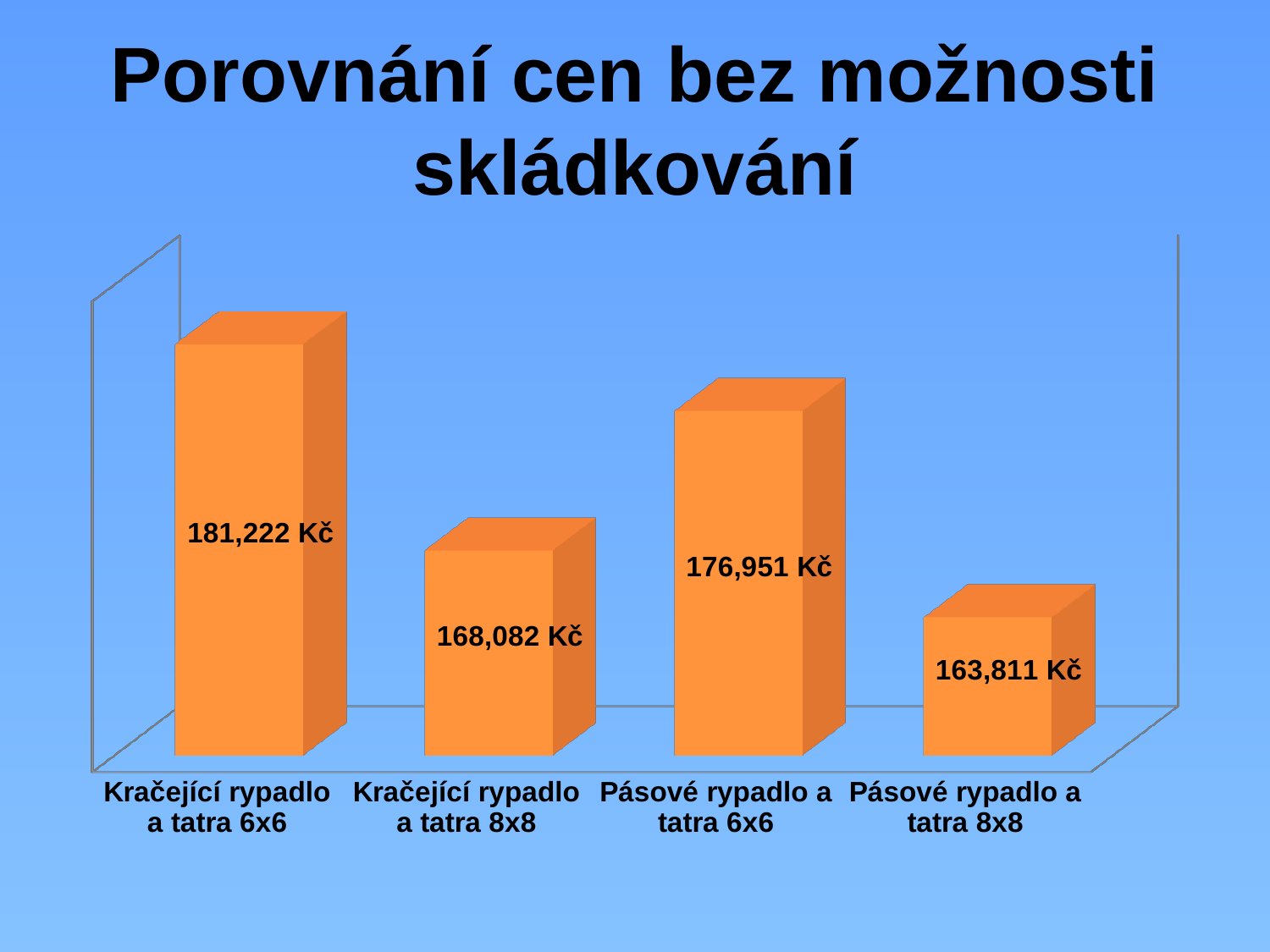
What is the value for Kračející rypadlo a tatra 8x8? 168,082 Kč How many categories are shown in the chart? 4 What is the difference between the values for Pásové rypadlo a tatra 6x6 and Pásové rypadlo a tatra 8x8? 13,140 Kč What kind of chart is shown on the slide? Bar chart What is the value for Kračející rypadlo a tatra 6x6? 181,222 Kč Which category has the lowest value? Pásové rypadlo a tatra 8x8 Which category has the highest value? Kračející rypadlo a tatra 6x6 What is the value for Pásové rypadlo a tatra 6x6? 176,951 Kč What is the difference between the values for Kračející rypadlo a tatra 6x6 and Kračející rypadlo a tatra 8x8? 13,140 Kč What is the value for Pásové rypadlo a tatra 8x8? 163,811 Kč What is the title of the slide? Porovnání cen bez možnosti skládkování Which is larger, the value for Kračející rypadlo a tatra 8x8 or the value for Pásové rypadlo a tatra 6x6? Pásové rypadlo a tatra 6x6